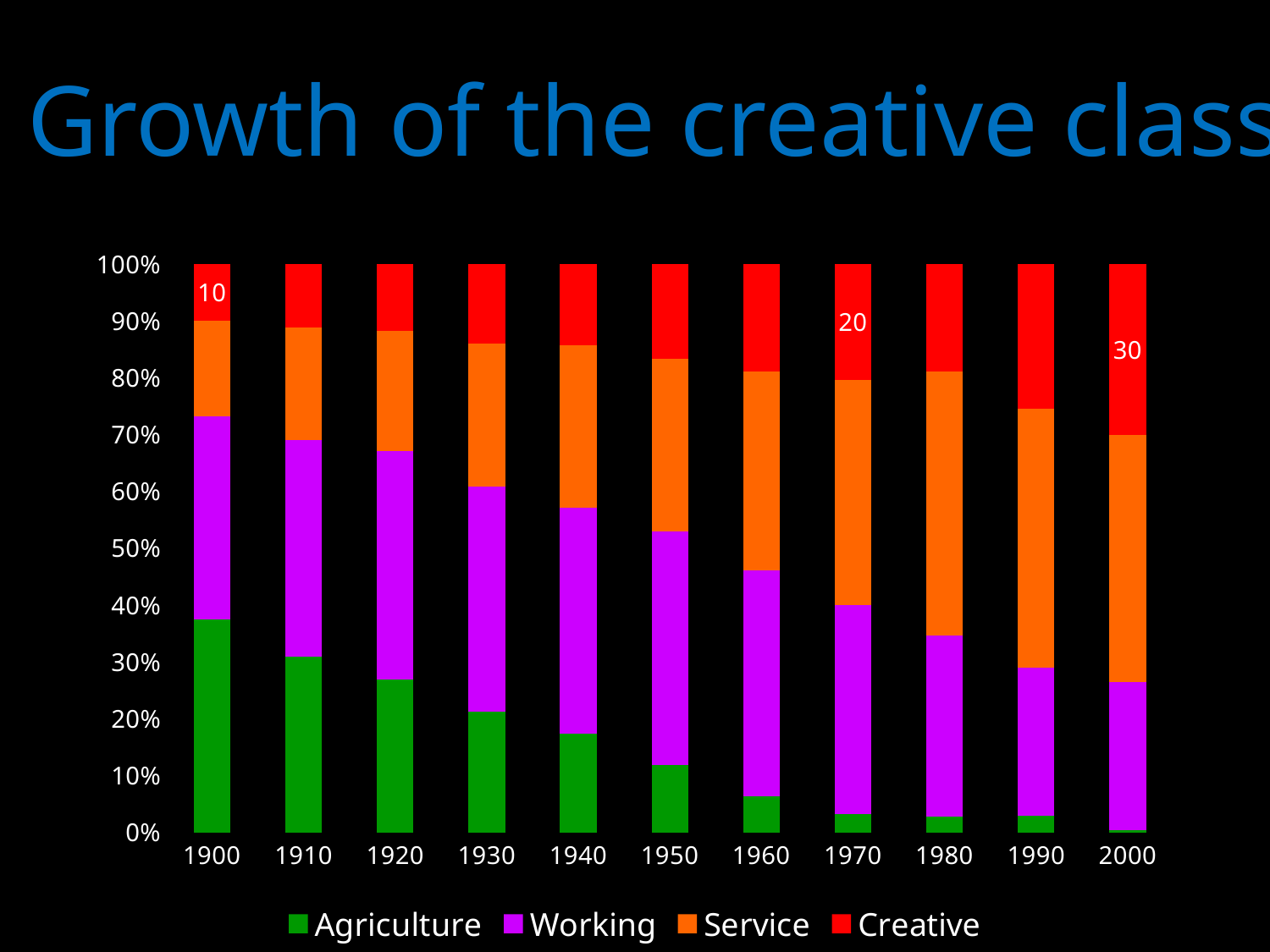
What is the title of the slide? Growth of the creative class Is the Agriculture share in 1900 greater or less than 30%? greater By how much does the labelled Creative value in 2000 exceed the labelled Creative value in 1900? 20 What is the data label shown for the Creative segment in 1970? 20 Is the Agriculture share in 1960 greater or less than 10%? less What is the data label shown for the Creative segment in 2000? 30 In which year is the Agriculture share the largest? 1900 What kind of chart is shown on the slide? Stacked bar chart What is the data label shown for the Creative segment in 1900? 10 Does the Agriculture share rise or fall from 1900 to 2000? Fall How many series does the legend list? 4 How many years are shown along the x axis? 11